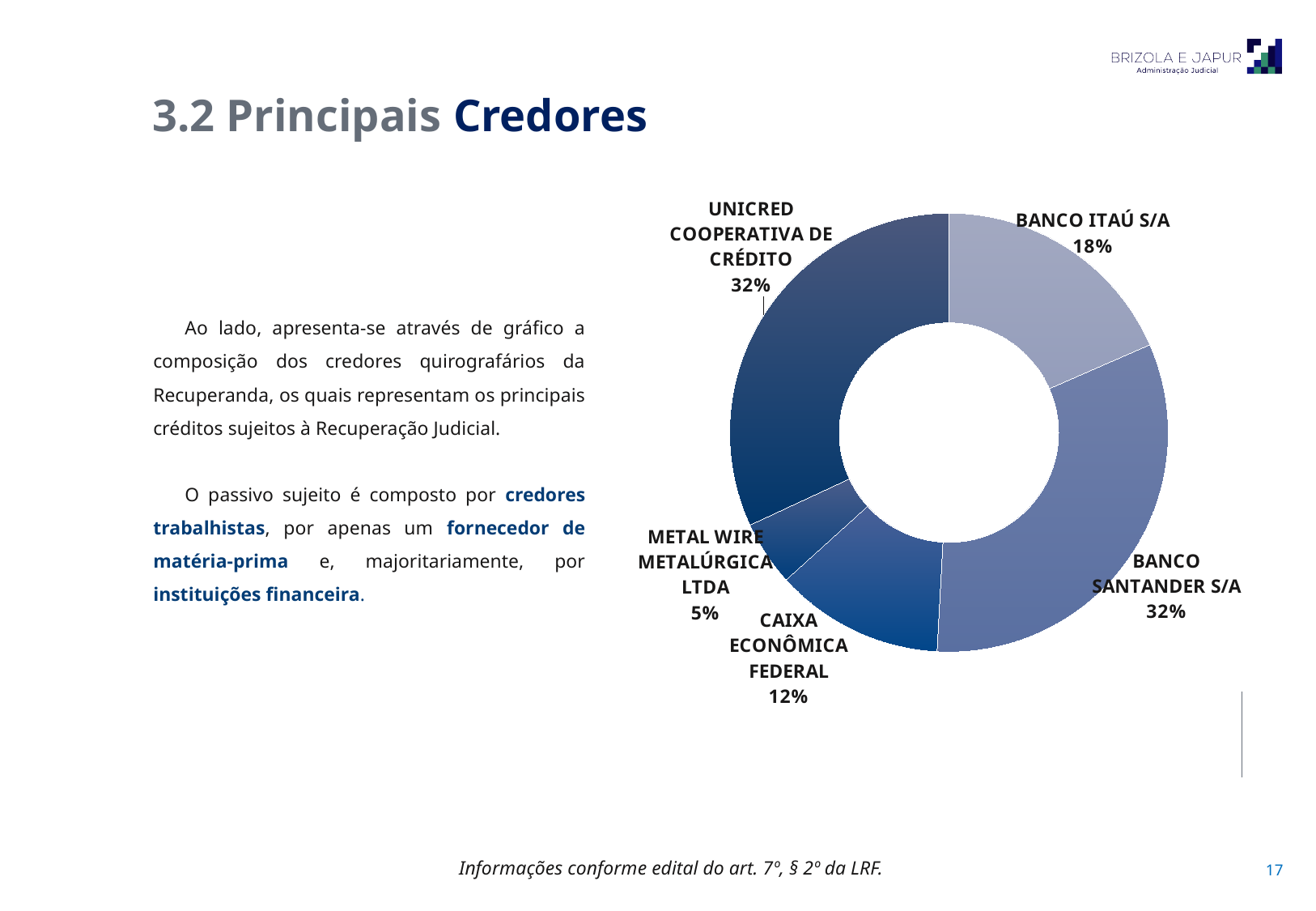
What is the difference in percentage points between CAIXA ECONÔMICA FEDERAL and METAL WIRE METALÚRGICA LTDA? 7 What kind of chart is shown on the slide? Donut (pie) chart How many creditors are shown in the chart? 5 What share of the chart does BANCO SANTANDER S/A represent? 32% Which has the larger share, BANCO ITAÚ S/A or CAIXA ECONÔMICA FEDERAL? BANCO ITAÚ S/A What percentage is shown for CAIXA ECONÔMICA FEDERAL? 12% What is the difference in percentage points between BANCO SANTANDER S/A and BANCO ITAÚ S/A? 14 What percentage is shown for BANCO ITAÚ S/A? 18% Which creditor has the smallest share in the chart? METAL WIRE METALÚRGICA LTDA What share does UNICRED COOPERATIVA DE CRÉDITO hold in the chart? 32% What percentage is shown for METAL WIRE METALÚRGICA LTDA? 5% Which has the larger share, UNICRED COOPERATIVA DE CRÉDITO or BANCO ITAÚ S/A? UNICRED COOPERATIVA DE CRÉDITO